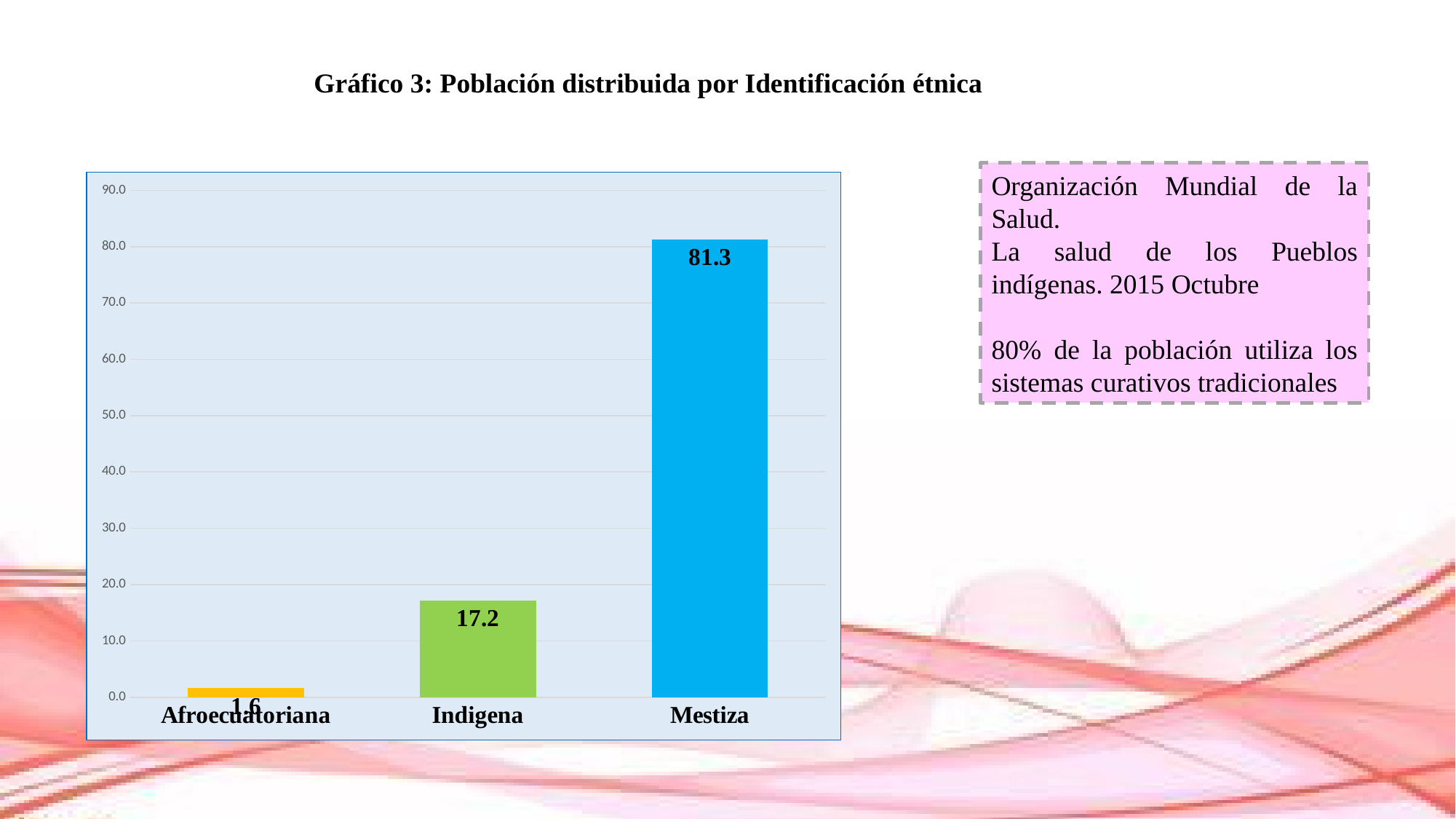
What is the value for Indigena? 17.2 Is the value for Mestiza greater or less than 80.0? greater What is the difference between the values for Mestiza and Indigena? 64.1 Which category has the highest value? Mestiza What is the title of the chart? Gráfico 3: Población distribuida por Identificación étnica What is the difference between the values for Indigena and Afroecuatoriana? 15.6 Which category has the lowest value? Afroecuatoriana What is the value for Afroecuatoriana? 1.6 How many categories are shown in the chart? 3 What kind of chart is shown on the slide? bar chart Which is larger, the value for Indigena or the value for Afroecuatoriana? Indigena What is the value for Mestiza? 81.3